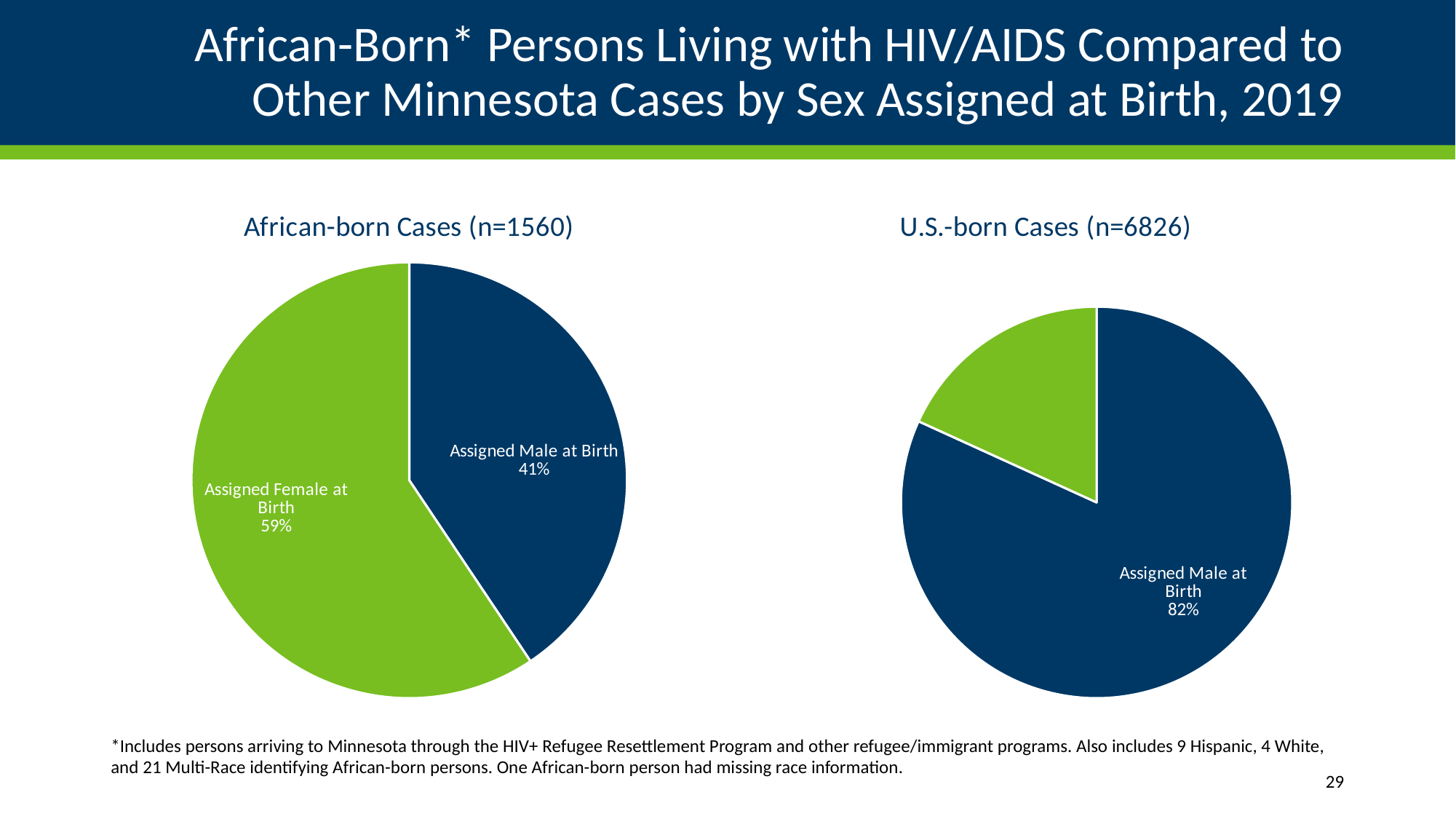
Which is larger: the Assigned Male at Birth share in the African-born Cases chart or the Assigned Male at Birth share in the U.S.-born Cases chart? U.S.-born Cases What is the sample size (n) shown in the title of the African-born Cases chart? 1560 In the African-born Cases chart, what percentage of cases were Assigned Male at Birth? 41% What is the sample size (n) shown in the title of the U.S.-born Cases chart? 6826 In the African-born Cases chart, which category has the smallest share? Assigned Male at Birth How many pie charts are shown on the slide? 2 How many slices does the African-born Cases pie chart have? 2 What type of chart is used for the African-born Cases? Pie chart In the African-born Cases chart, what is the difference in percentage points between Assigned Female at Birth and Assigned Male at Birth? 18 In the African-born Cases chart, which category has the largest share? Assigned Female at Birth In the U.S.-born Cases chart, what percentage of cases were Assigned Male at Birth? 82% In the African-born Cases chart, what percentage of cases were Assigned Female at Birth? 59%